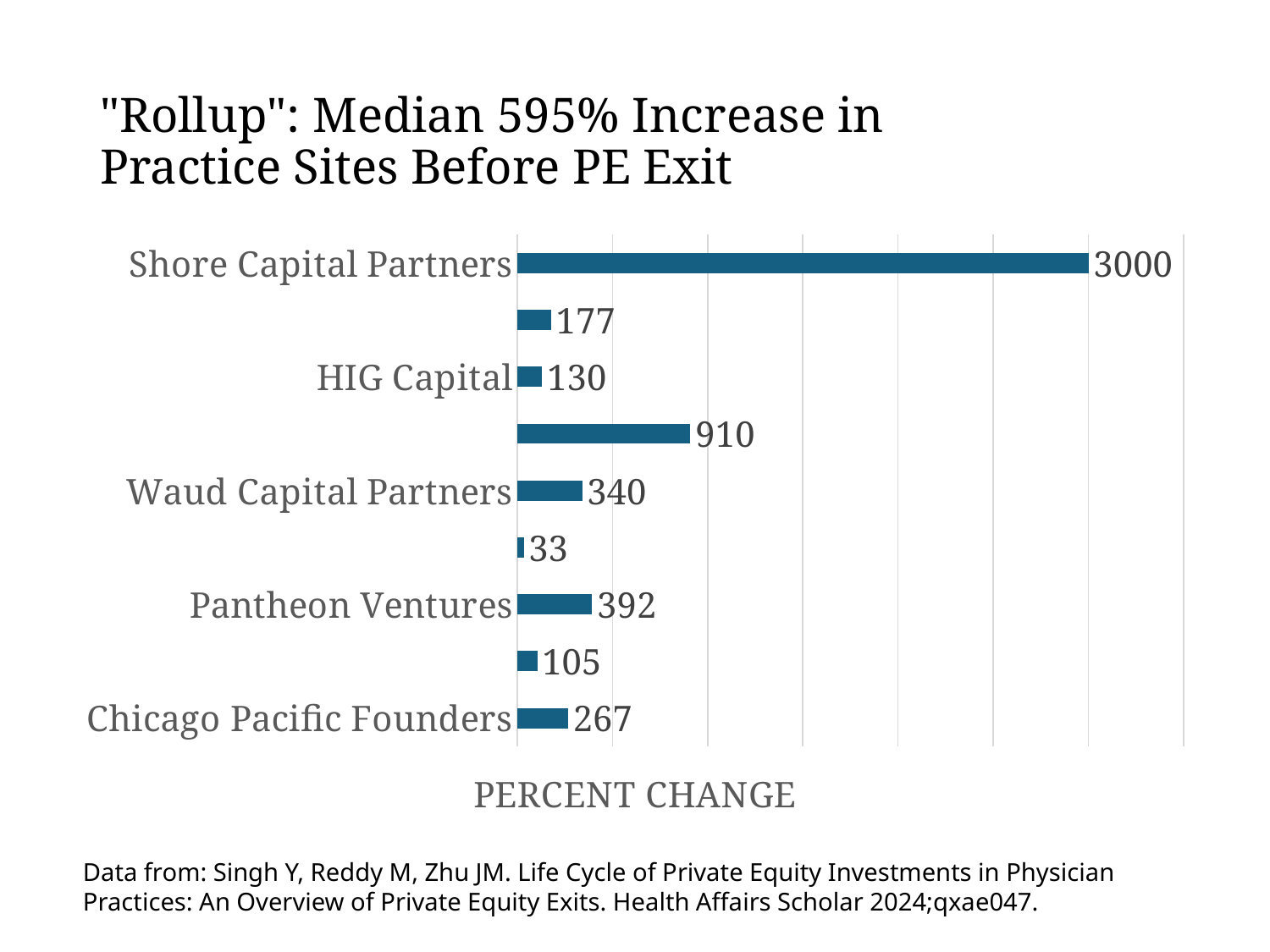
What is the percent change for Pantheon Ventures? 392 What is the percent change for HIG Capital? 130 What is the percent change for Waud Capital Partners? 340 What is the label on the horizontal axis of the chart? PERCENT CHANGE Which is larger, the percent change for Chicago Pacific Founders or HIG Capital? Chicago Pacific Founders What is the percent change for Shore Capital Partners? 3000 What kind of chart is shown on the slide? Bar chart What is the percent change for Chicago Pacific Founders? 267 What is the difference between the percent change for Pantheon Ventures and Waud Capital Partners? 52 Which firm has the highest percent change? Shore Capital Partners What is the smallest value shown on the chart? 33 How many bars are plotted on the chart? 9